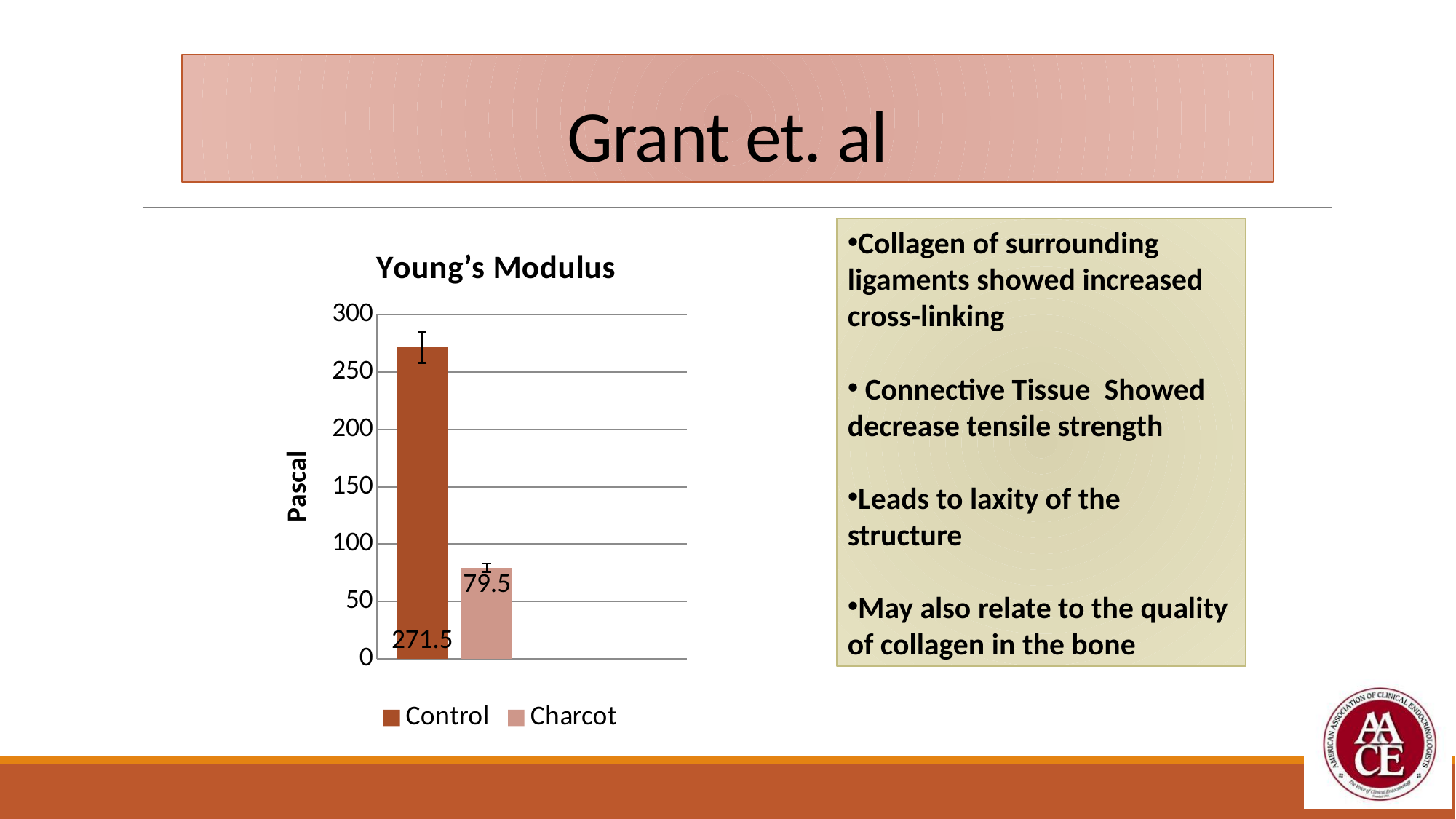
What is the label on the vertical axis of the Young's Modulus chart? Pascal How many series does the legend of the Young's Modulus chart list? 2 Is the value for Control larger or smaller than the value for Charcot? larger What is the difference between the Control and Charcot values in the Young's Modulus chart? 192 Is the value for Charcot greater or less than 100? less Is the value for Control greater or less than 250? greater What kind of chart is the Young's Modulus chart? bar chart What is the value for Control in the Young's Modulus chart? 271.5 Which series has the higher value in the Young's Modulus chart? Control What is the title of the chart on the slide? Young's Modulus What is the value for Charcot in the Young's Modulus chart? 79.5 Which series has the lower value in the Young's Modulus chart? Charcot